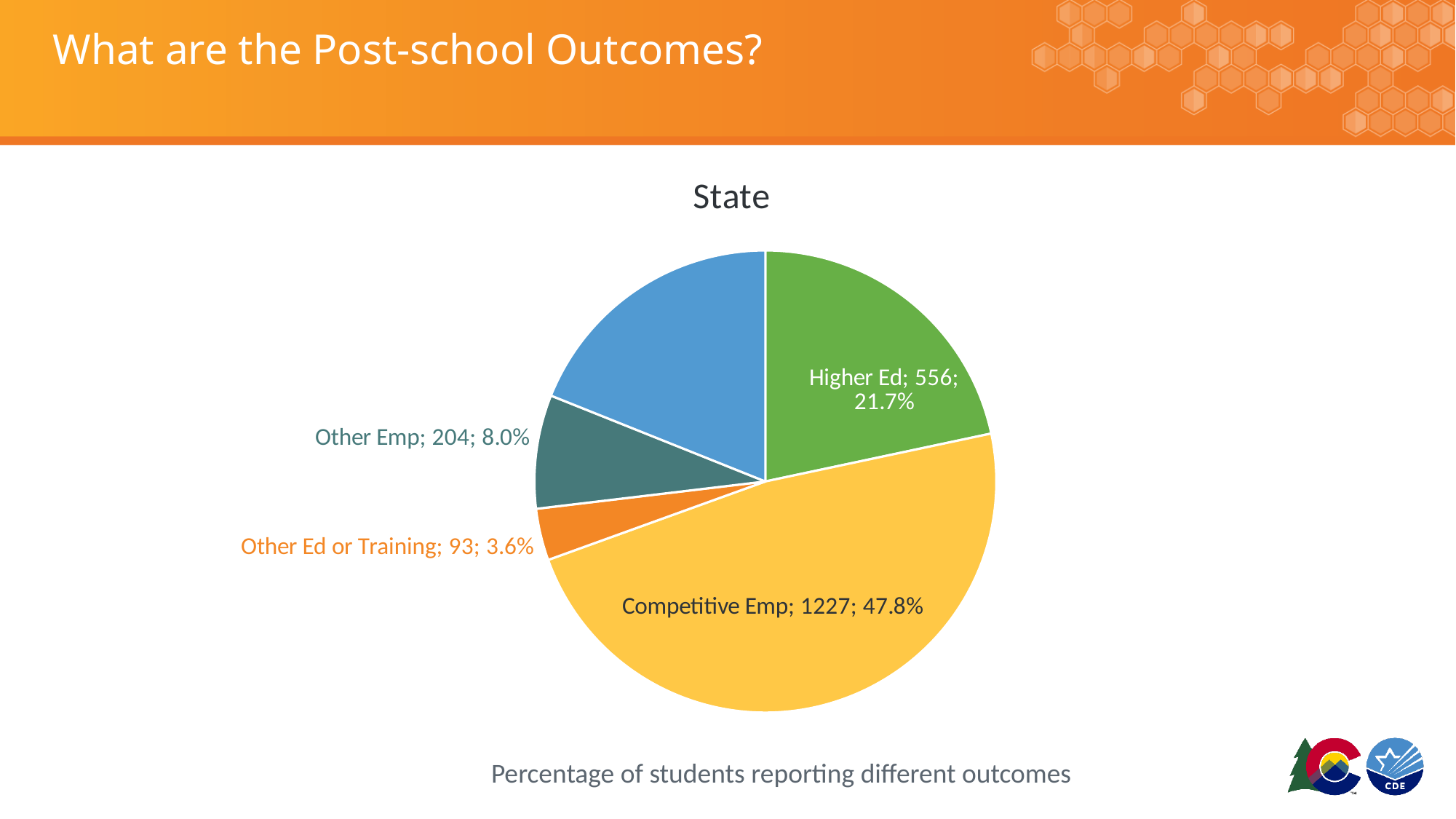
What percentage of students does the Higher Ed slice represent? 21.7% How many more students are in Other Emp than in Other Ed or Training? 111 Which slice is larger, Higher Ed or Other Emp? Higher Ed Which outcome has the smallest slice of the pie? Other Ed or Training How many more students are in Competitive Emp than in Higher Ed? 671 How many students are in the Other Emp slice? 204 What is the title of the chart? State How many students are in the Competitive Emp slice? 1227 How many slices does the pie chart have? 5 What percentage of students does the Other Ed or Training slice represent? 3.6% Which outcome has the largest slice of the pie? Competitive Emp What type of chart is shown on the slide? pie chart